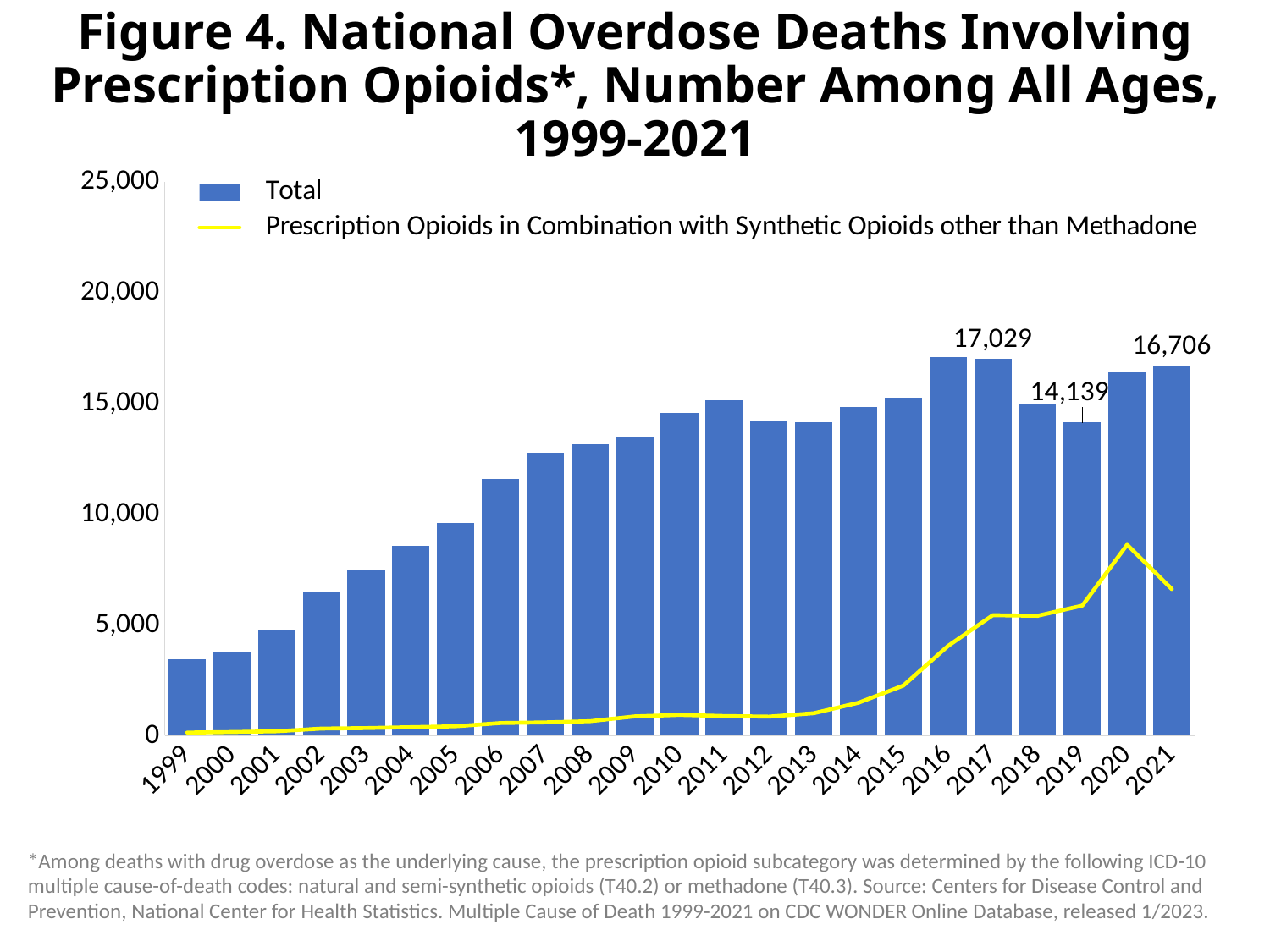
What is the difference between the 2021 total and the 2019 total? 2,567 Is the total for 1999 greater or less than 5,000? less What is the total number of overdose deaths involving prescription opioids in 2021? 16,706 Which year has the lowest total number of deaths? 1999 What colour is the line for Prescription Opioids in Combination with Synthetic Opioids other than Methadone? Yellow Which year has the larger total, 2016 or 2019? 2016 How many series does the legend list? 2 How many years are shown on the x axis? 23 What is the total number of overdose deaths involving prescription opioids in 2019? 14,139 Is the total for 2002 greater or less than 5,000? greater